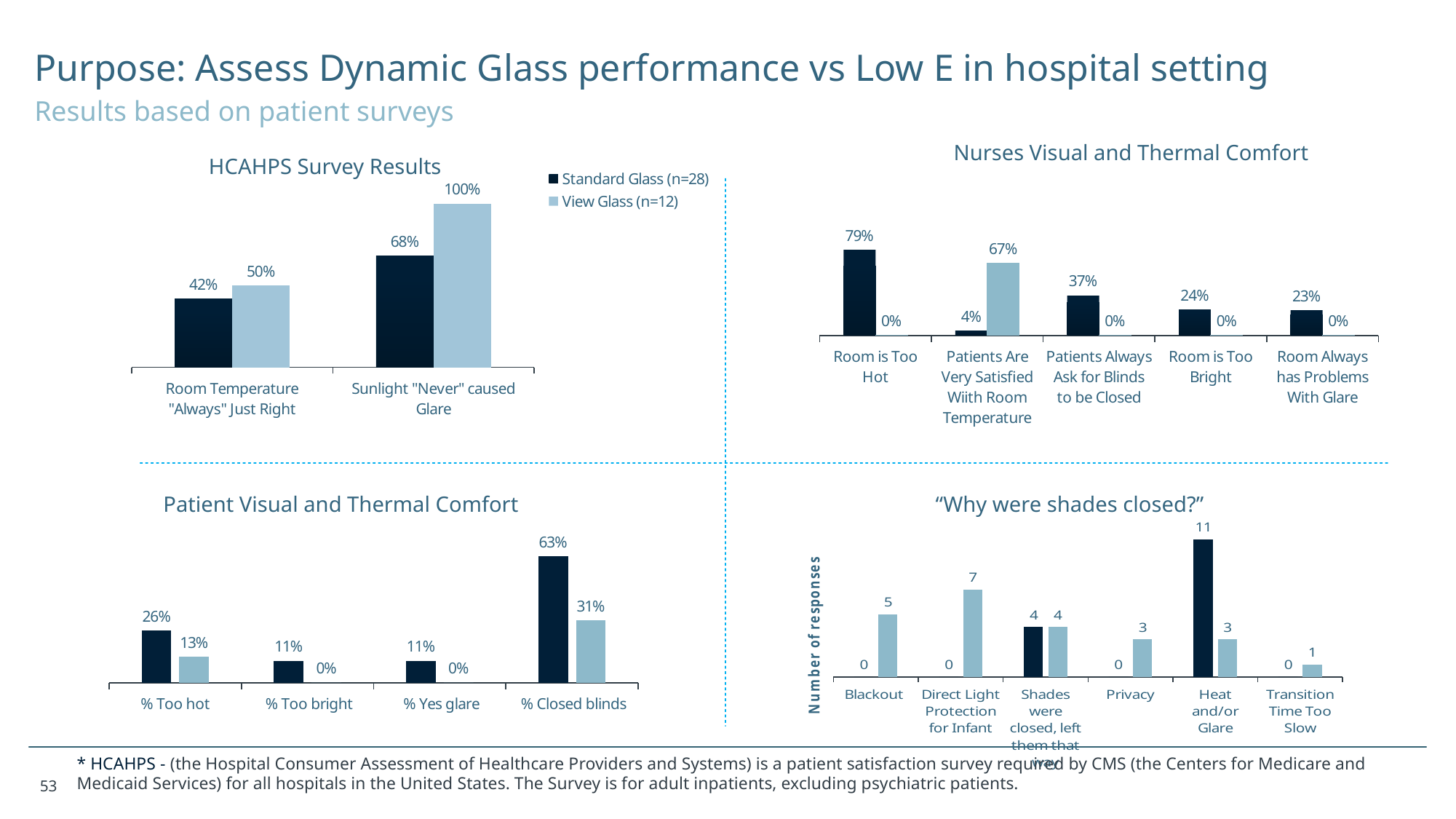
In the HCAHPS Survey Results chart, what is the View Glass (n=12) value for Sunlight "Never" caused Glare? 100% How many series does the legend of the HCAHPS Survey Results chart list? 2 In the Patient Visual and Thermal Comfort chart, what is the value of the dark bar for % Closed blinds? 63% How many categories are shown on the x axis of the Nurses Visual and Thermal Comfort chart? 5 In the HCAHPS Survey Results chart, what is the Standard Glass (n=28) value for Room Temperature "Always" Just Right? 42% In the "Why were shades closed?" chart, which category has the highest value? Heat and/or Glare In the Nurses Visual and Thermal Comfort chart, which category has the highest light blue bar? Patients Are Very Satisfied Wiith Room Temperature In the HCAHPS Survey Results chart, how much higher is the View Glass value than the Standard Glass value for Sunlight "Never" caused Glare? 32 percentage points In the Patient Visual and Thermal Comfort chart, what is the difference between the dark bar and the light blue bar for % Too hot? 13 percentage points In the "Why were shades closed?" chart, what is the value of the light blue bar for Direct Light Protection for Infant? 7 In the Nurses Visual and Thermal Comfort chart, what is the value of the dark bar for Room is Too Hot? 79% What is the y-axis label of the "Why were shades closed?" chart? Number of responses